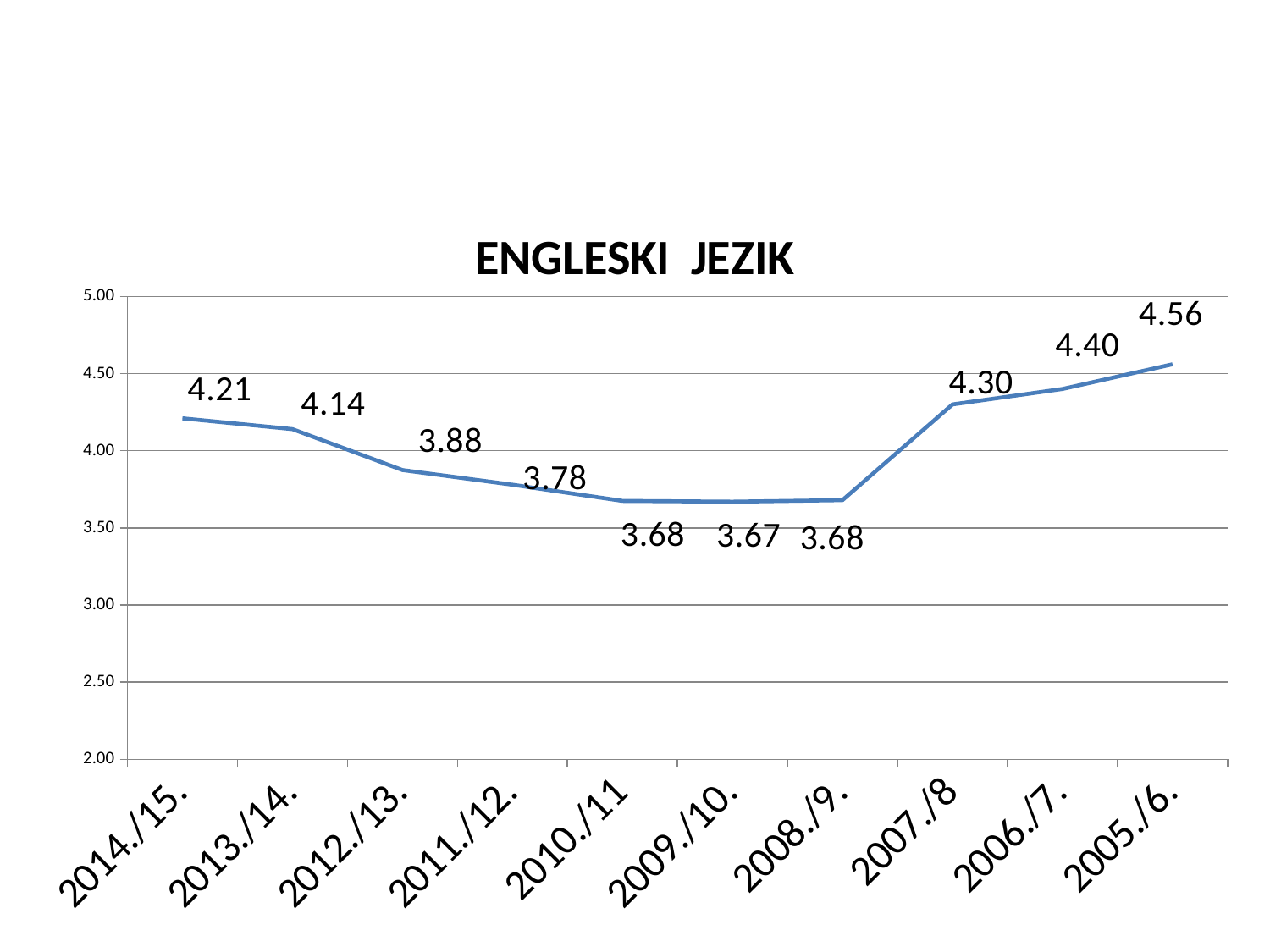
Is the value for 2012./13. greater or less than 4.00? less What is the title of the chart? ENGLESKI JEZIK What is the difference between the values for 2005./6. and 2014./15.? 0.35 What is the value for 2007./8? 4.30 What kind of chart is this? line chart How many categories are shown on the x axis? 10 Which category has the highest value? 2005./6. Do the values rise or fall from 2014./15. to 2010./11? fall Which is larger, the value for 2013./14. or the value for 2006./7.? 2006./7. What is the difference between the values for 2007./8 and 2008./9.? 0.62 What is the value for 2014./15.? 4.21 What is the value for 2011./12.? 3.78